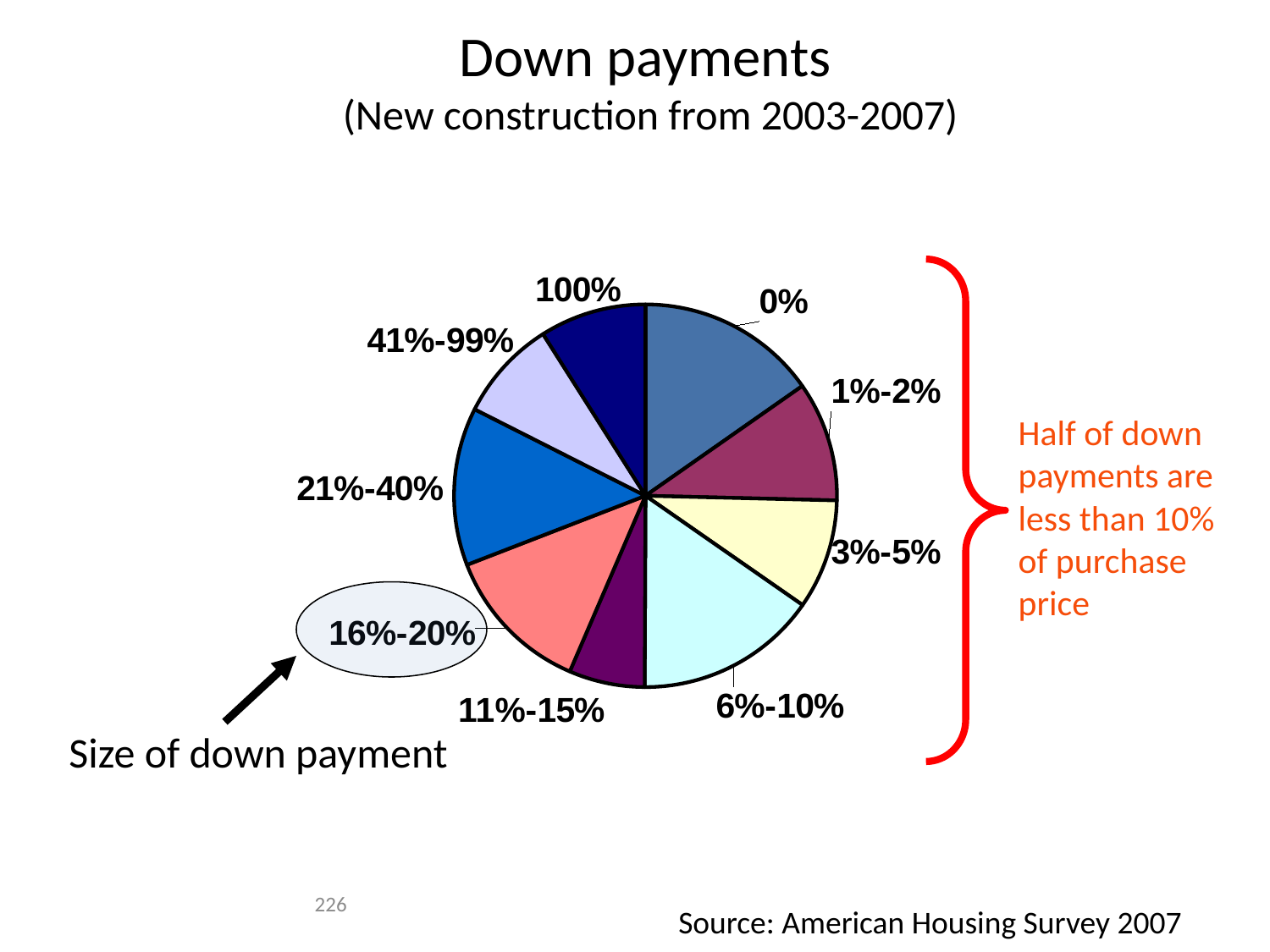
How many slices does the pie chart have? 9 Which slice is larger, 3%-5% or 11%-15%? 3%-5% What kind of chart is shown on the slide? pie chart Which slice is larger, 0% or 1%-2%? 0% Which down payment category has the smallest slice of the pie? 11%-15% What source is cited for the chart? American Housing Survey 2007 What is the title of the chart? Down payments (New construction from 2003-2007) Which slice is larger, 6%-10% or 11%-15%? 6%-10%